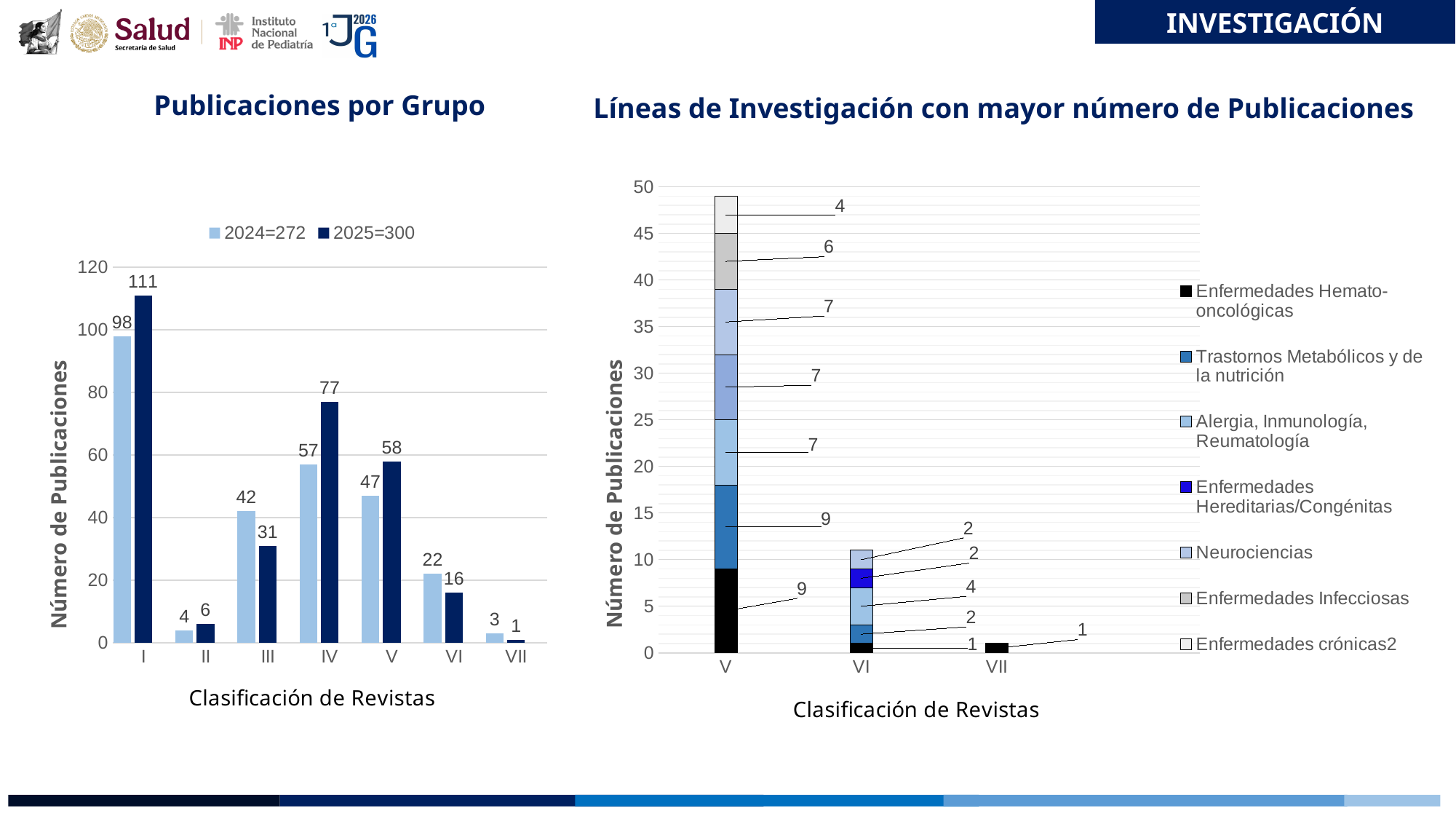
In the chart 'Líneas de Investigación con mayor número de Publicaciones', what is the total of the stacked bar for VI? 11 In the chart 'Publicaciones por Grupo', what is the difference between the 2025 and 2024 values for group I? 13 In the chart 'Líneas de Investigación con mayor número de Publicaciones', what is the value of Enfermedades Hemato-oncológicas for V? 9 In the chart 'Publicaciones por Grupo', for group III, which series is larger, 2024 or 2025? 2024 In the chart 'Publicaciones por Grupo', what is the 2025 value for group IV? 77 In the chart 'Publicaciones por Grupo', what is the 2024 value for group V? 47 In the chart 'Líneas de Investigación con mayor número de Publicaciones', how many series does the legend list? 7 In the chart 'Líneas de Investigación con mayor número de Publicaciones', what is the total of the stacked bar for V? 49 In the chart 'Publicaciones por Grupo', how many groups are shown on the x axis? 7 In the chart 'Publicaciones por Grupo', how many series does the legend list? 2 In the chart 'Publicaciones por Grupo', what kind of chart is shown? bar chart In the chart 'Publicaciones por Grupo', which group has the highest 2024 value? I